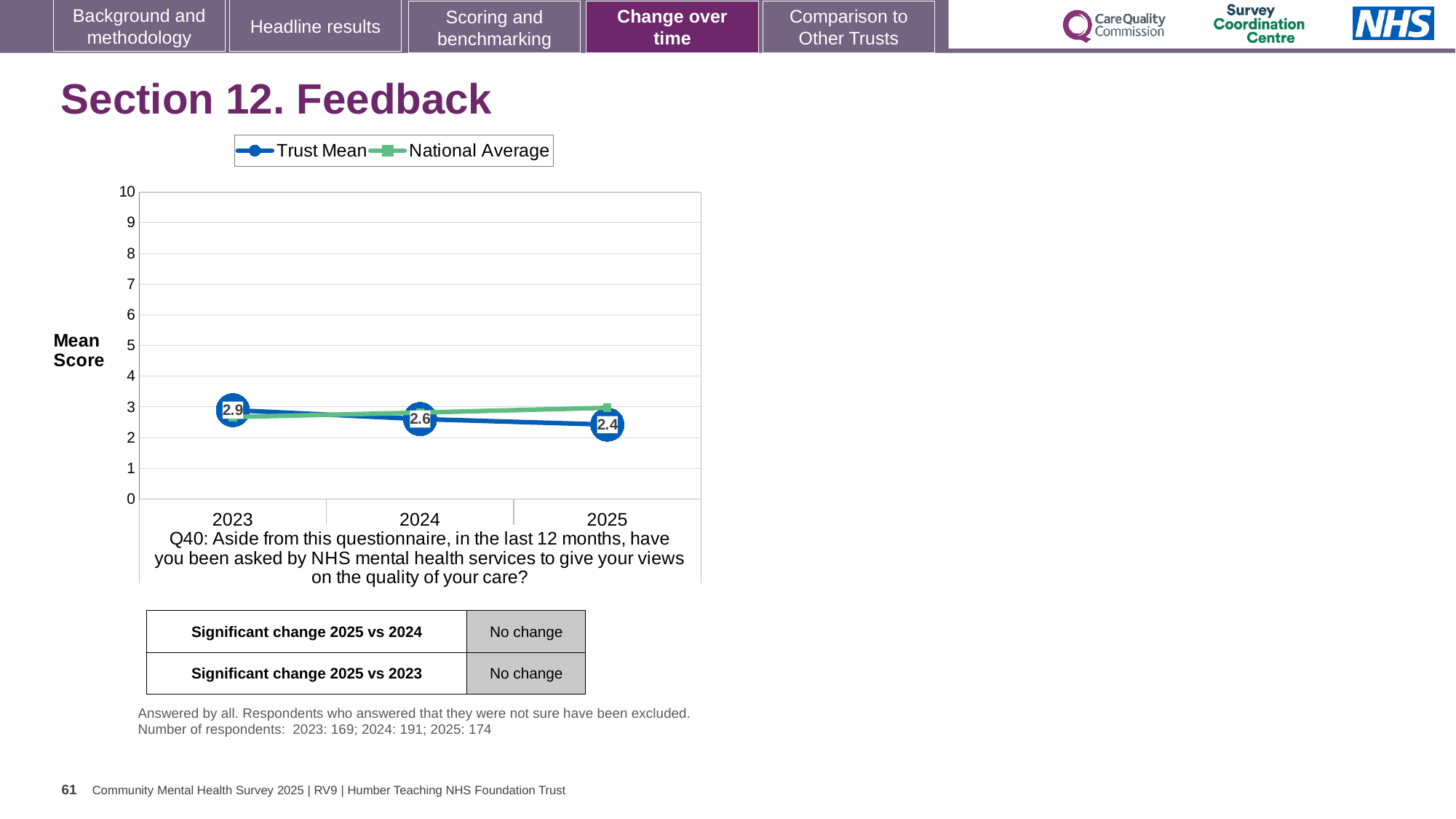
What is the Trust Mean score for 2023? 2.9 How many series does the legend list? 2 In which year is the Trust Mean score highest? 2023 What kind of chart is shown on the slide? Line chart Is the National Average value for 2025 greater or less than 2? greater How many years are shown on the x axis? 3 What is the Trust Mean score for 2024? 2.6 In which year is the Trust Mean score lowest? 2025 Does the Trust Mean rise or fall from 2023 to 2025? Fall What is the Trust Mean score for 2025? 2.4 In 2025, which is larger: the Trust Mean or the National Average? National Average What is the difference between the Trust Mean scores for 2023 and 2025? 0.5